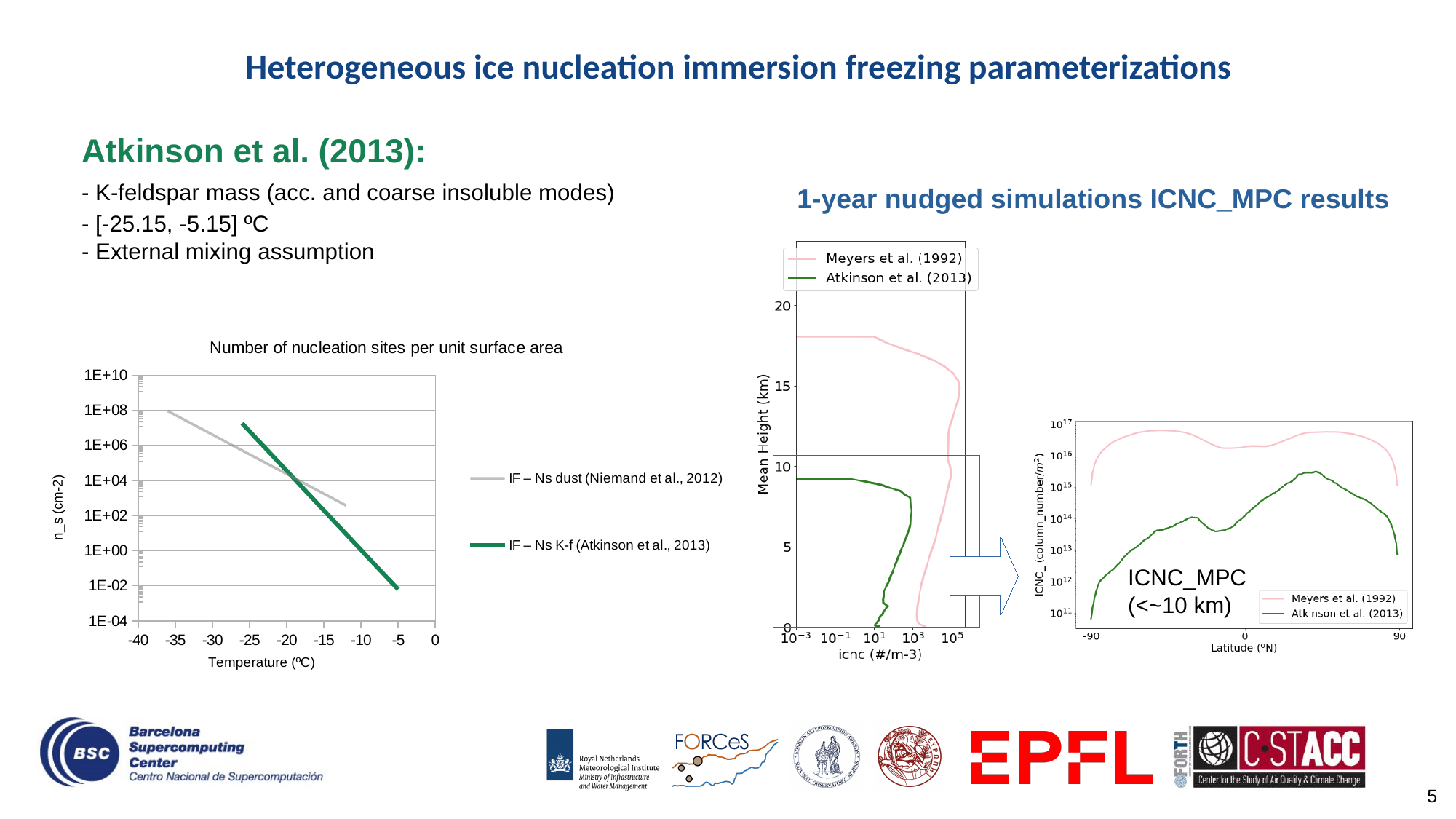
In the middle chart of icnc versus Mean Height (km), which series has the larger icnc at a height of 5 km? Meyers et al. (1992) In the middle chart of icnc versus Mean Height (km), which series reaches the greater height, Meyers et al. (1992) or Atkinson et al. (2013)? Meyers et al. (1992) In the 'Number of nucleation sites per unit surface area' chart, is the value of the IF – Ns K-f (Atkinson et al., 2013) line at -5 ºC greater or less than 1E+00? less What kind of chart is the 'Number of nucleation sites per unit surface area' chart on the left? line chart In the right-hand chart of ICNC versus Latitude (ºN), which series has the higher values across latitudes, Meyers et al. (1992) or Atkinson et al. (2013)? Meyers et al. (1992) How many series does the legend of the 'Number of nucleation sites per unit surface area' chart list? 2 In the right-hand chart of ICNC versus Latitude (ºN), is the peak value of the Atkinson et al. (2013) line greater or less than 10^15? greater What is the x-axis label of the 'Number of nucleation sites per unit surface area' chart? Temperature (ºC) In the middle chart of icnc versus Mean Height (km), is the maximum height reached by the Atkinson et al. (2013) line greater or less than 10 km? less In the 'Number of nucleation sites per unit surface area' chart, do the values rise or fall as temperature increases from -40 to 0 ºC? fall